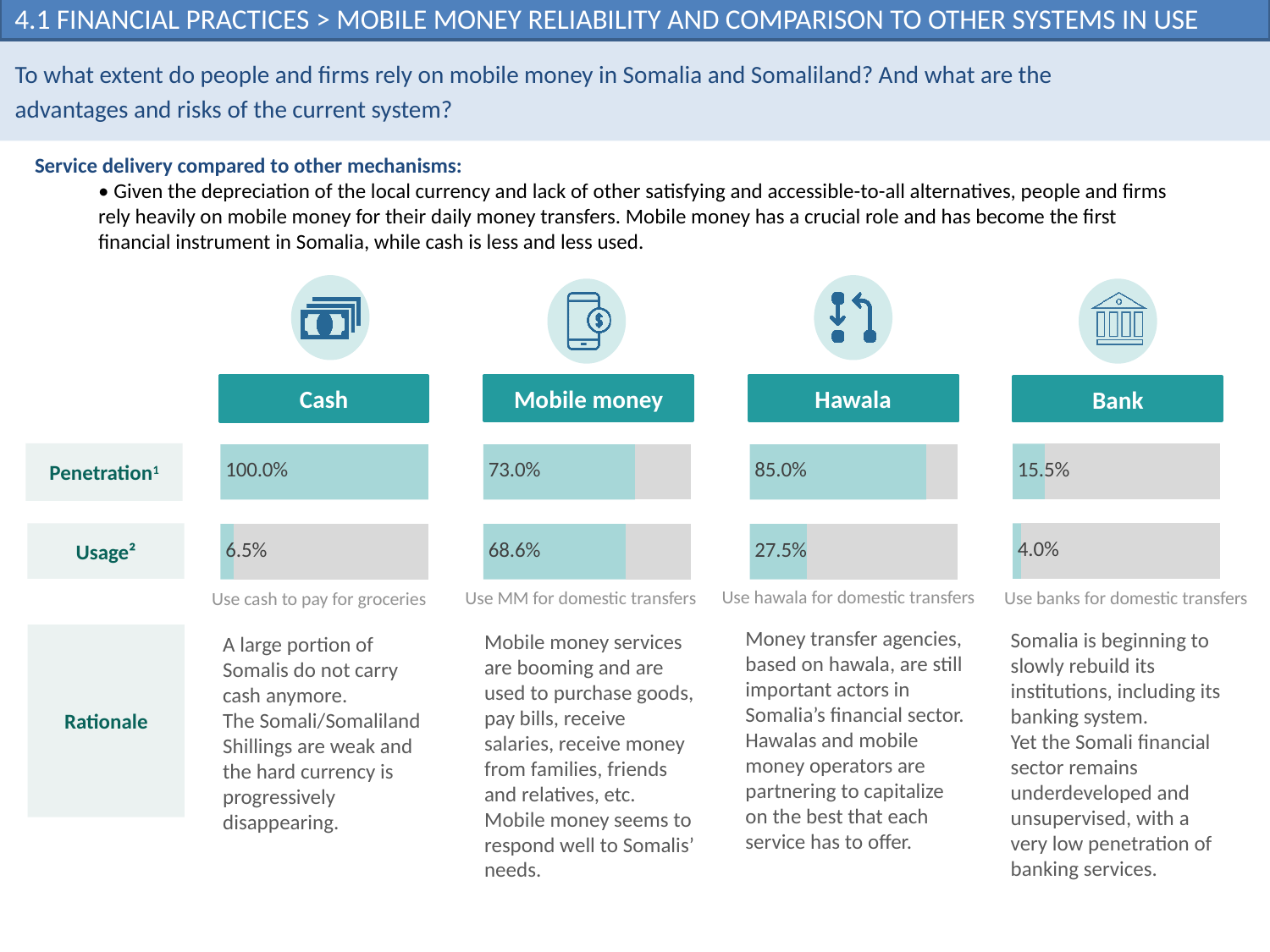
Which mechanism has the highest Usage value? Mobile money Which is larger, the Usage value for Cash or the Usage value for Bank? Cash What is the difference between the Usage values for Mobile money and Hawala? 41.1% What is the Penetration value shown for Bank? 15.5% What is the difference between the Penetration values for Hawala and Mobile money? 12.0% What is the Usage value shown for Cash? 6.5% How many mechanisms are compared in the Penetration and Usage bars? 4 What is the Penetration value shown for Mobile money? 73.0% Which mechanism has the highest Penetration value? Cash What is the Usage value shown for Hawala? 27.5% What kind of chart is used to show the Penetration and Usage values? Bar chart Which mechanism has the lowest Usage value? Bank